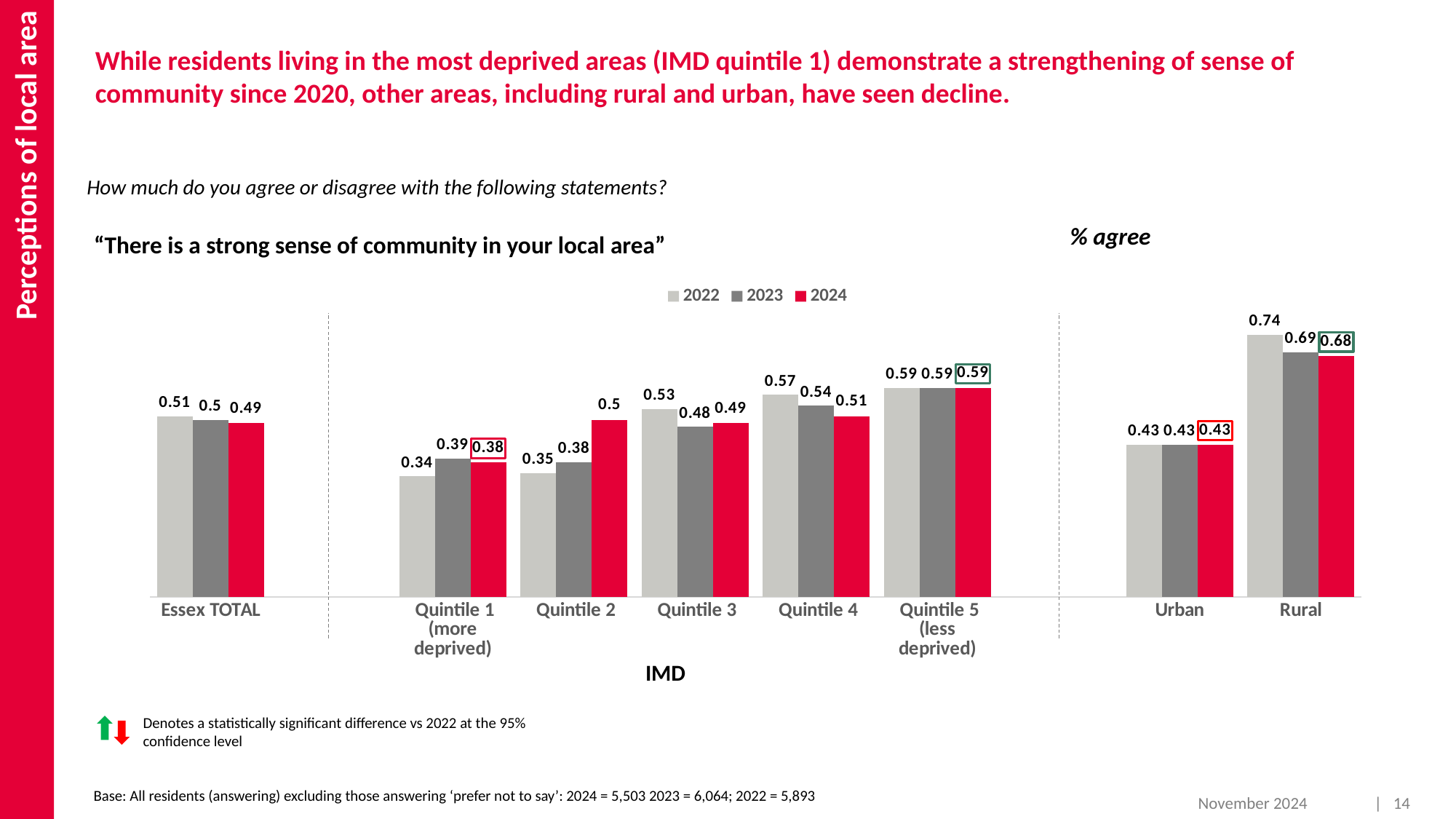
How many categories are shown on the x axis? 8 Which series is shown in red in the legend? 2024 What is the 2023 value for Essex TOTAL? 0.5 What is the 2024 value for Rural? 0.68 Which is larger: the 2024 value for Quintile 3 or the 2024 value for Quintile 4? Quintile 4 Do the 2022 values rise or fall from Quintile 1 to Quintile 5? Rise What is the 2022 value for Quintile 1 (more deprived)? 0.34 Which category has the highest 2022 value? Rural How many series does the legend list? 3 What kind of chart is shown on the slide? Bar chart Which category has the lowest 2022 value? Quintile 1 (more deprived) What is the difference between the 2024 value for Quintile 2 and the 2022 value for Quintile 2? 0.15